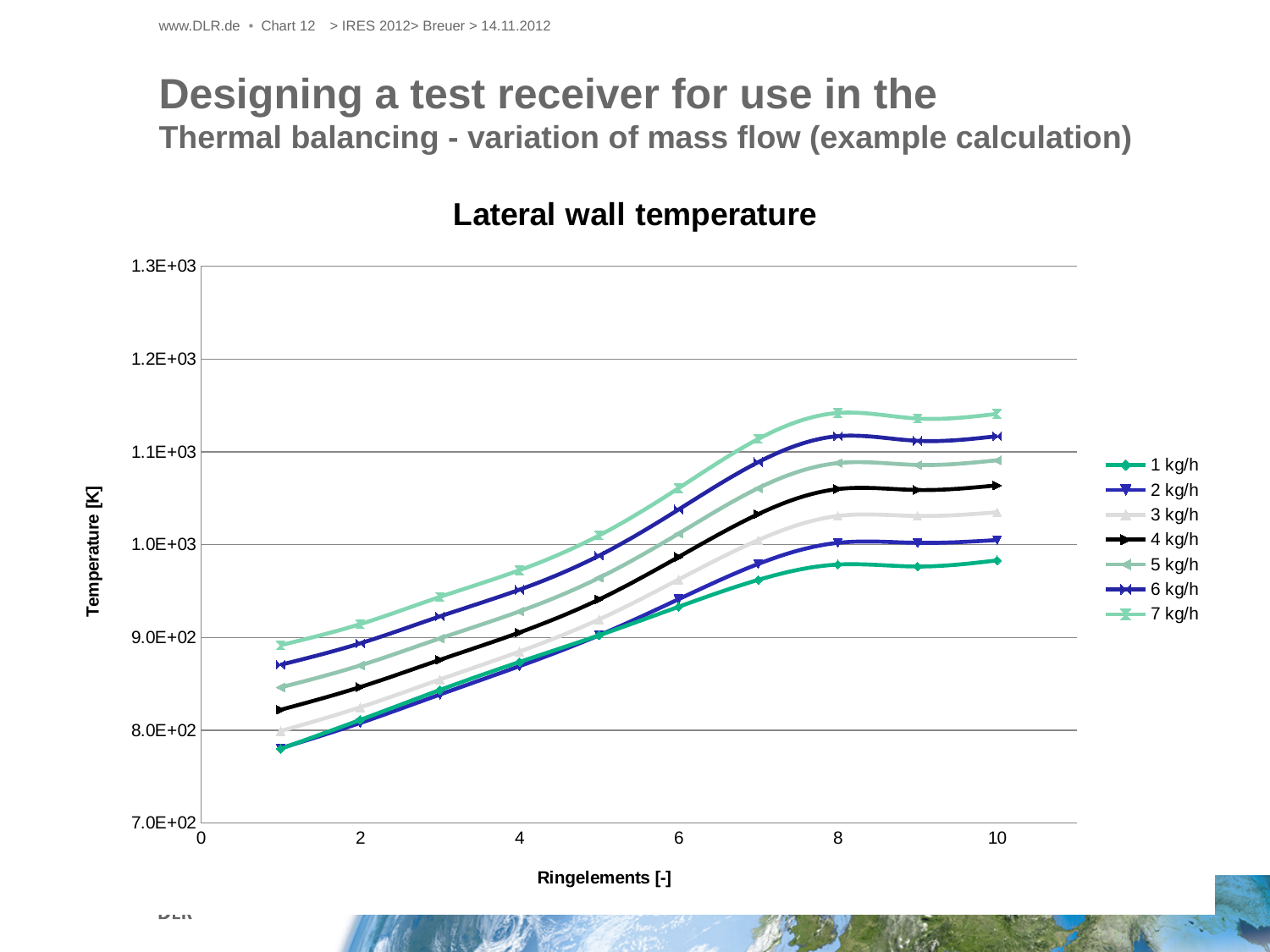
How many ring elements (data points) are plotted for each series? 10 Which series has the highest temperature at ring element 10? 7 kg/h What is the title of the chart? Lateral wall temperature Is the value for 6 kg/h at ring element 1 greater or less than 9.0E+02? less How many series does the legend list? 7 Which series has the lowest temperature at ring element 10? 1 kg/h Is the value for 7 kg/h at ring element 8 greater or less than 1.1E+03? greater At ring element 5, which is larger: the value for 7 kg/h or the value for 1 kg/h? 7 kg/h Is the value for 4 kg/h at ring element 10 greater or less than 1.0E+03? greater Does the temperature for the 7 kg/h series generally rise or fall from ring element 1 to ring element 8? rise What kind of chart is shown on the slide? Line chart